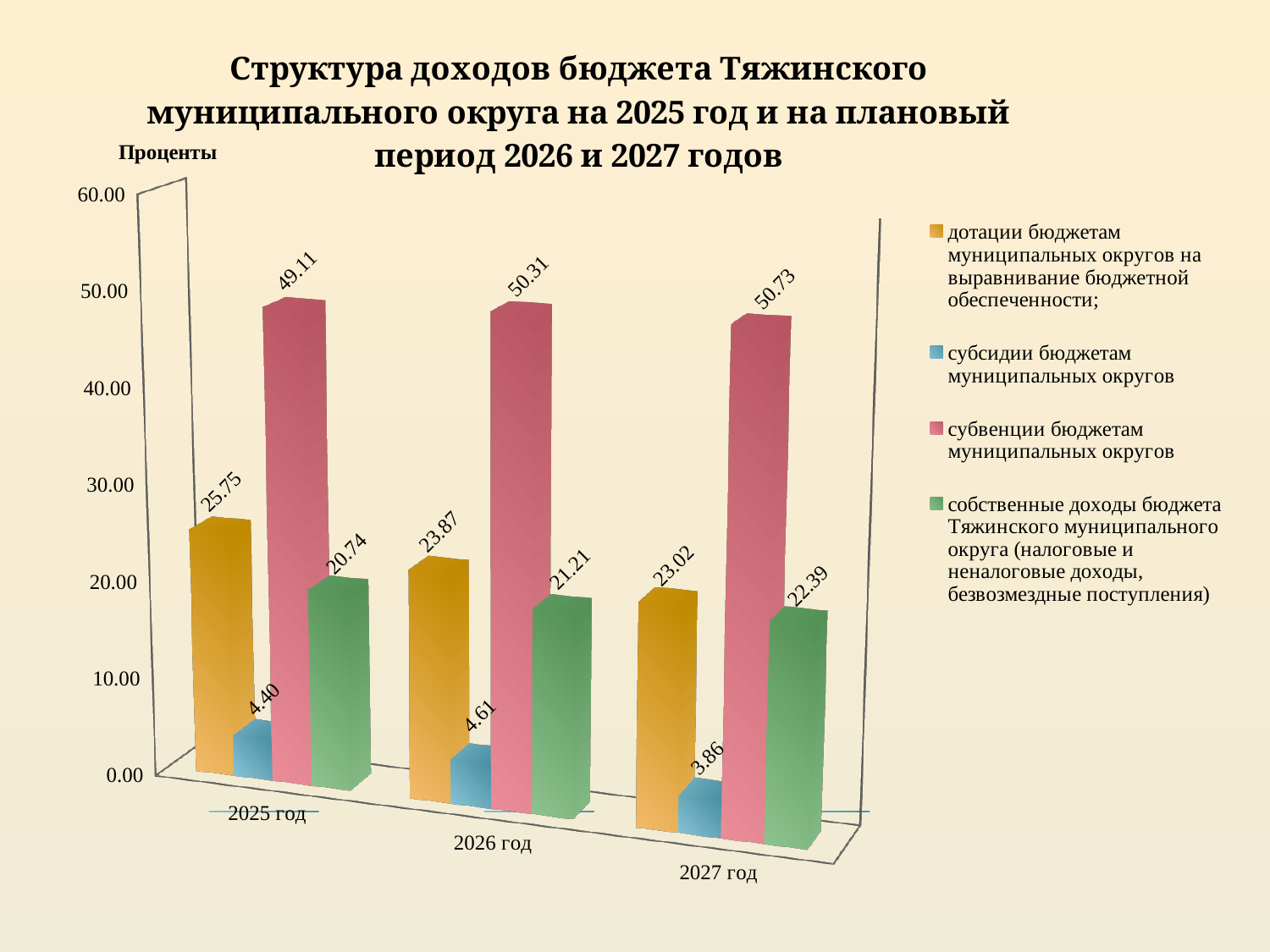
How many years (categories) are shown on the x axis? 3 What kind of chart is shown on the slide? bar chart What is the value for дотации бюджетам муниципальных округов на выравнивание бюджетной обеспеченности in 2026 год? 23.87 What is the value for субвенции бюджетам муниципальных округов in 2025 год? 49.11 What is the difference between the дотации values for 2025 год and 2027 год? 2.73 Do the values for собственные доходы бюджета rise or fall from 2025 год to 2027 год? rise In which year is the value for субсидии бюджетам муниципальных округов lowest? 2027 год How many series does the legend list? 4 What is the value for собственные доходы бюджета Тяжинского муниципального округа in 2027 год? 22.39 Which is larger in 2026 год: дотации бюджетам муниципальных округов or собственные доходы бюджета? дотации бюджетам муниципальных округов What is the value for субсидии бюджетам муниципальных округов in 2027 год? 3.86 In which year is the value for субвенции бюджетам муниципальных округов highest? 2027 год